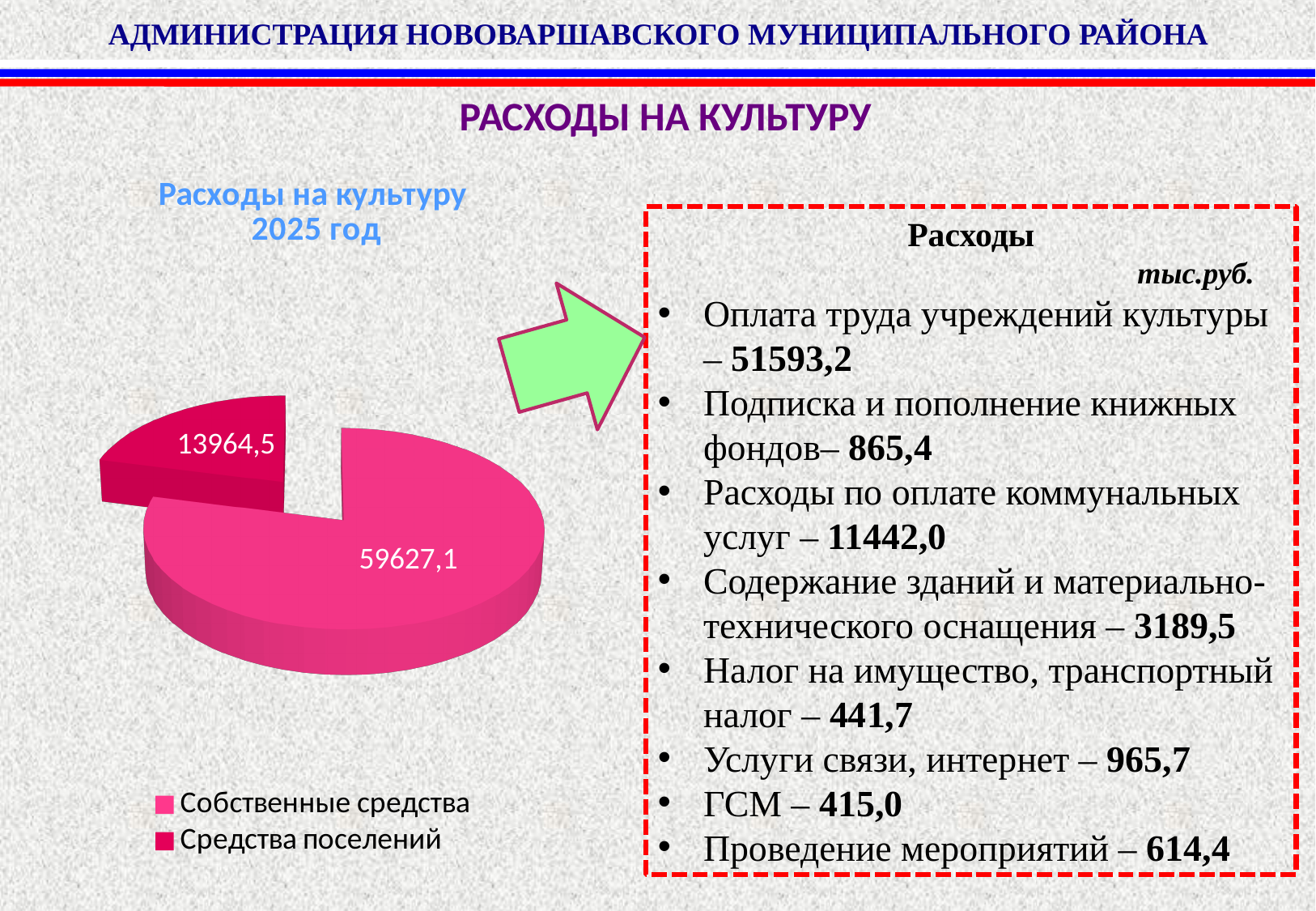
How many entries does the legend of the pie chart list? 2 Which is larger: Собственные средства or Средства поселений? Собственные средства What is the value for Собственные средства in the pie chart? 59627,1 Which category has the largest slice in the pie chart? Собственные средства What is the total of the two slices in the pie chart? 73591,6 What is the value for Средства поселений in the pie chart? 13964,5 What is the title of the pie chart? Расходы на культуру 2025 год Which category has the smallest slice in the pie chart? Средства поселений What kind of chart is shown on the slide? Pie chart What is the difference between the values for Собственные средства and Средства поселений? 45662,6 How many slices does the pie chart have? 2 What share of the pie does Собственные средства represent? 81%